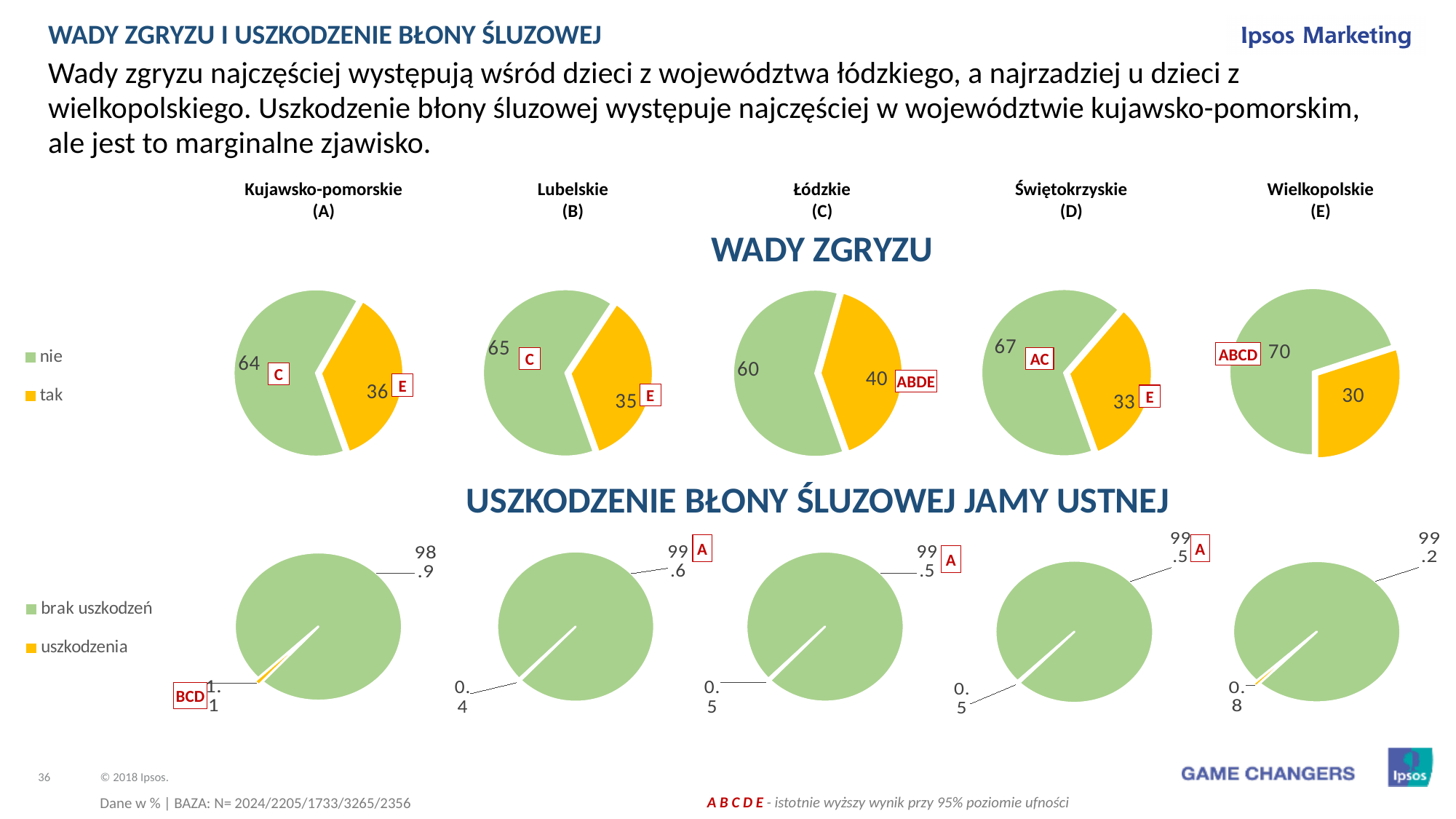
How many entries does the legend for the USZKODZENIE BŁONY ŚLUZOWEJ JAMY USTNEJ charts list? 2 In the WADY ZGRYZU pie chart for Wielkopolskie (E), what is the value for "nie"? 70 In the USZKODZENIE BŁONY ŚLUZOWEJ JAMY USTNEJ pie chart for Kujawsko-pomorskie (A), what is the value for "uszkodzenia"? 1.1 In the WADY ZGRYZU charts, what is the difference between the "tak" value for Kujawsko-pomorskie (A) and Świętokrzyskie (D)? 3 Across the USZKODZENIE BŁONY ŚLUZOWEJ JAMY USTNEJ pie charts, which voivodeship has the highest value for "uszkodzenia"? Kujawsko-pomorskie (A) Across the WADY ZGRYZU pie charts, which voivodeship has the lowest value for "tak"? Wielkopolskie (E) In the WADY ZGRYZU charts, which is larger: the "tak" value for Lubelskie (B) or for Łódzkie (C)? Łódzkie (C) In the WADY ZGRYZU pie chart for Łódzkie (C), what is the value for "tak"? 40 What kind of chart is used for the WADY ZGRYZU section? Pie chart In the USZKODZENIE BŁONY ŚLUZOWEJ JAMY USTNEJ pie chart for Lubelskie (B), what is the value for "brak uszkodzeń"? 99.6 How many pie charts are shown in the WADY ZGRYZU row? 5 Across the WADY ZGRYZU pie charts, which voivodeship has the highest value for "tak"? Łódzkie (C)